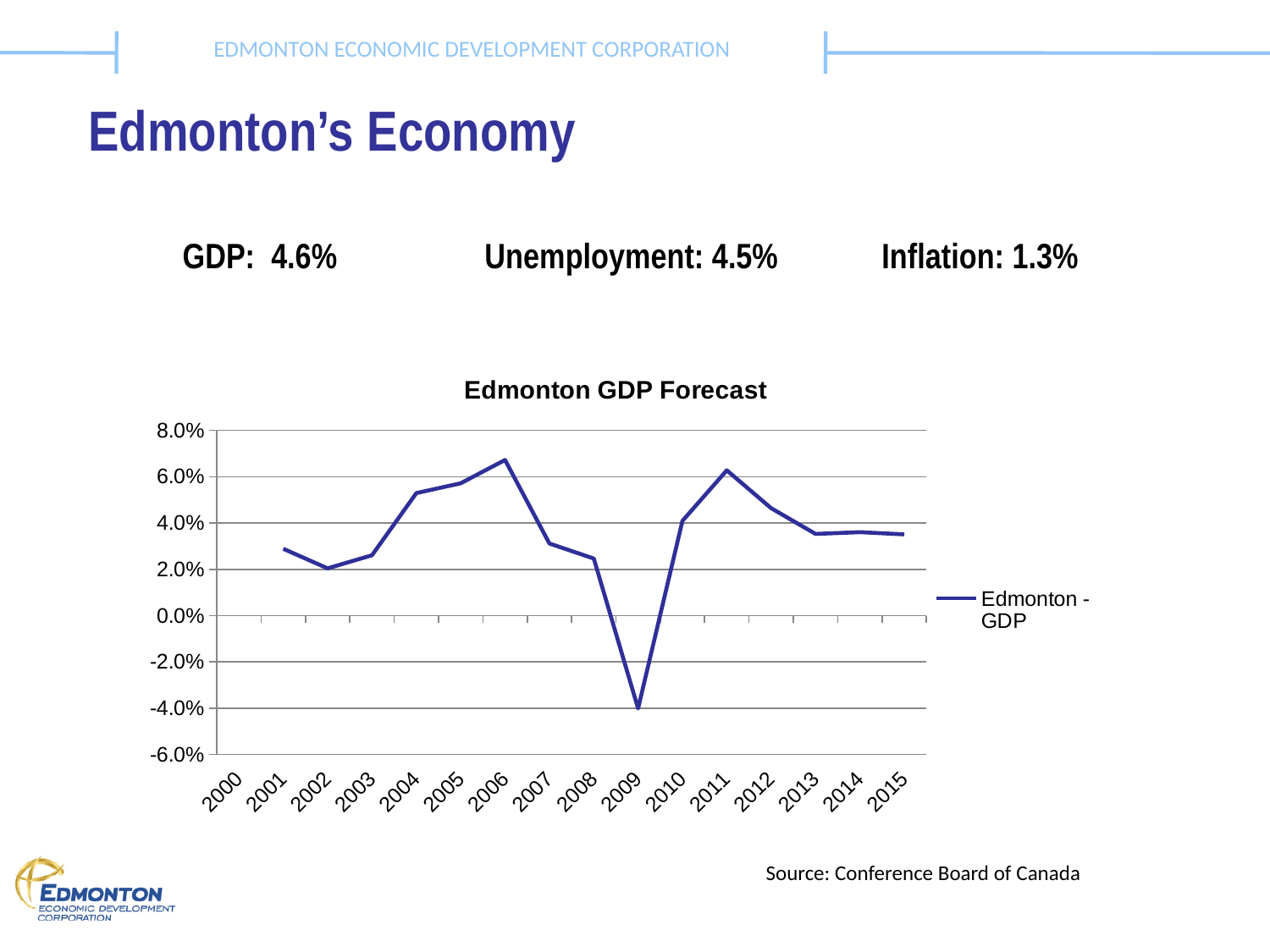
What is the name of the series shown in the legend of the Edmonton GDP Forecast chart? Edmonton - GDP Does the Edmonton GDP Forecast line rise or fall from 2011 to 2013? fall In which year does the Edmonton GDP Forecast line reach its highest value? 2006 Does the Edmonton GDP Forecast line rise or fall from 2002 to 2006? rise Is the value for 2009 in the Edmonton GDP Forecast chart greater or less than 0.0%? less How many series does the legend of the Edmonton GDP Forecast chart list? 1 Which year has the larger GDP value in the Edmonton GDP Forecast chart, 2004 or 2002? 2004 What is the title of the chart on the slide? Edmonton GDP Forecast In which year does the Edmonton GDP Forecast line reach its lowest value? 2009 What kind of chart is the Edmonton GDP Forecast chart? line chart Is the value for 2002 in the Edmonton GDP Forecast chart greater or less than 4.0%? less Is the value for 2006 in the Edmonton GDP Forecast chart greater or less than 6.0%? greater